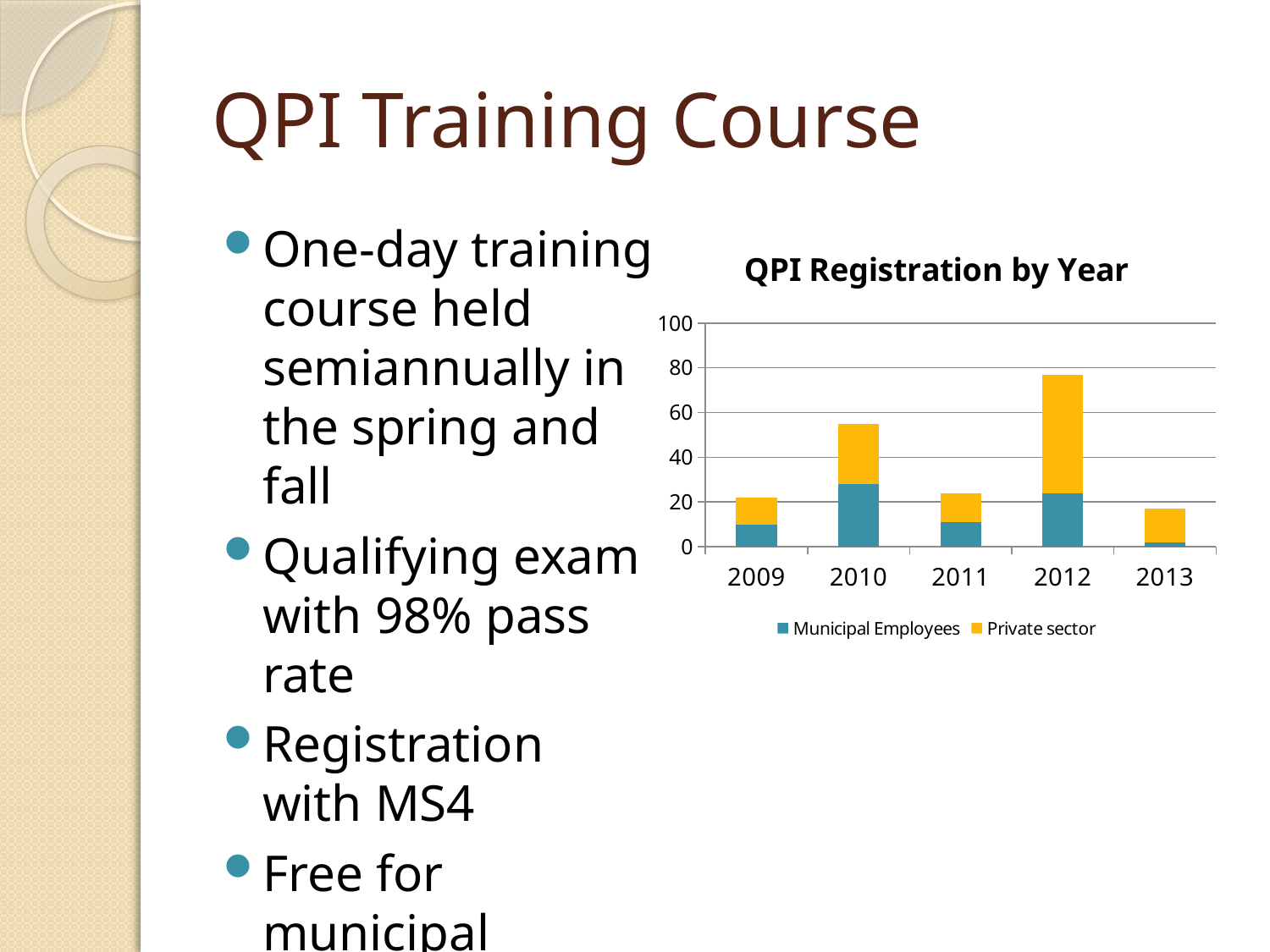
Is the total registration for 2013 greater or less than 20? less Is the total registration for 2012 greater or less than 60? greater Is the total registration for 2010 greater or less than 40? greater Which year has the highest total QPI registration? 2012 Which year has the lowest number of Municipal Employees registered? 2013 Which year has the lowest total QPI registration? 2013 Which year has the larger total registration, 2010 or 2011? 2010 How many years are shown on the x axis of the chart? 5 What is the title of the chart? QPI Registration by Year Which year has the highest number of Municipal Employees registered? 2010 What kind of chart is shown on the slide? Bar chart How many series does the chart's legend list? 2